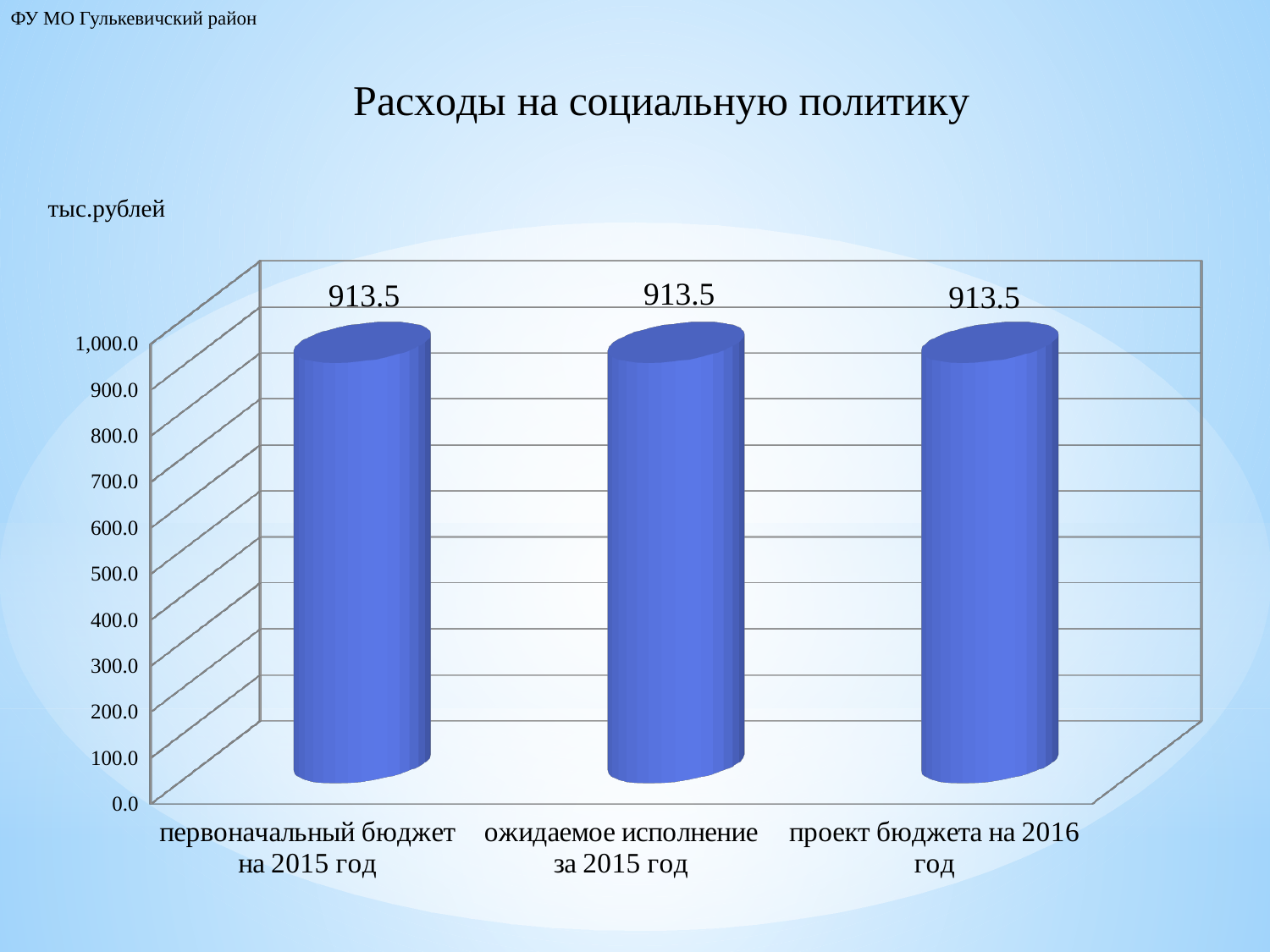
Which is larger: the value for 'ожидаемое исполнение за 2015 год' or the value for 'проект бюджета на 2016 год'? They are equal What is the difference between the value for 'проект бюджета на 2016 год' and the value for 'первоначальный бюджет на 2015 год'? 0.0 Is the value for 'проект бюджета на 2016 год' greater or less than 1,000.0? less How many categories are shown on the chart? 3 Do the values rise, fall, or stay the same across the categories from left to right? stay the same In what units are the values on the chart expressed? тыс.рублей What kind of chart is shown on the slide? bar chart What is the title of the chart? Расходы на социальную политику Is the value for 'первоначальный бюджет на 2015 год' greater or less than 900.0? greater What is the value for 'первоначальный бюджет на 2015 год'? 913.5 What is the value for 'ожидаемое исполнение за 2015 год'? 913.5 What is the value for 'проект бюджета на 2016 год'? 913.5